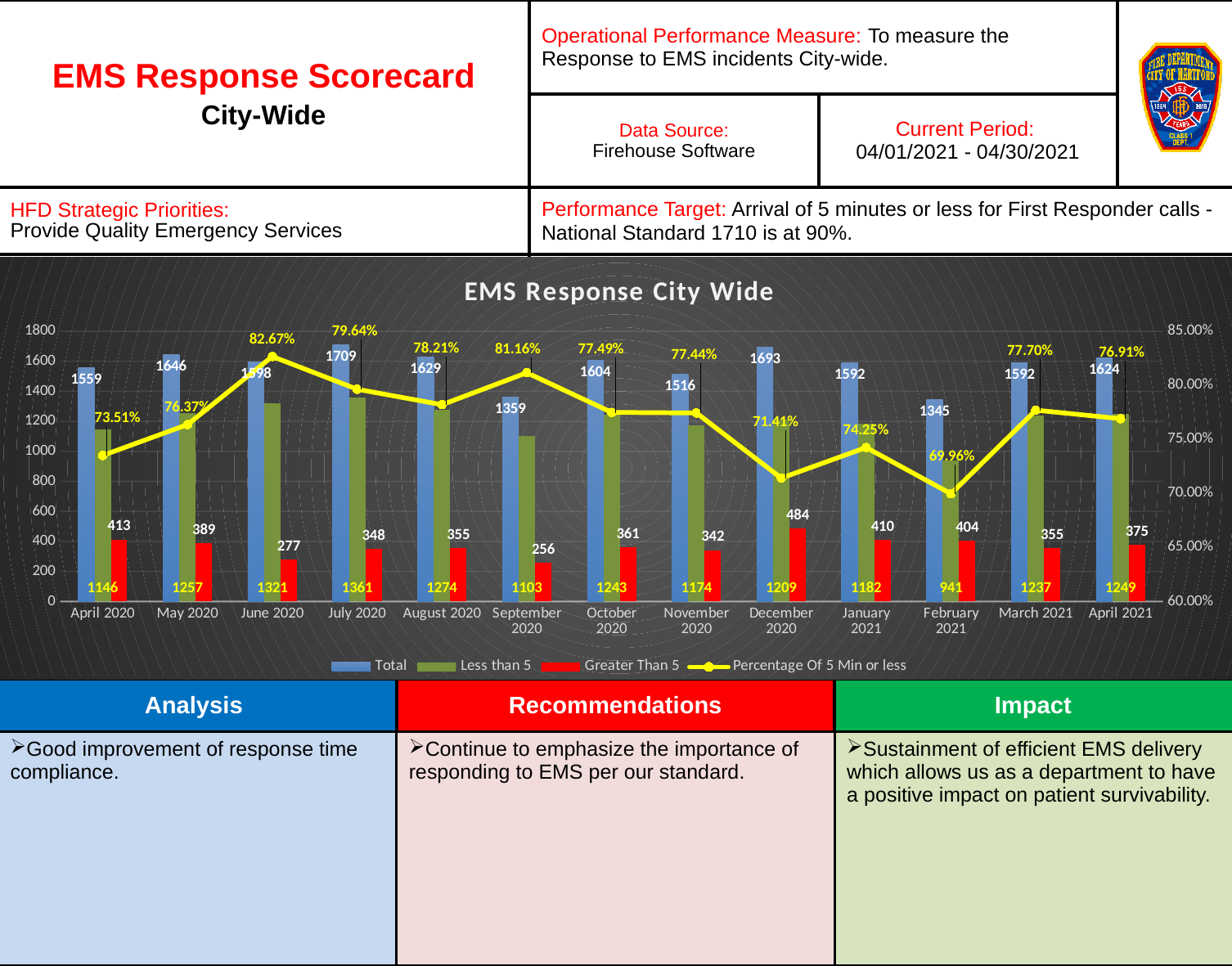
Which month has the lowest Percentage Of 5 Min or less? February 2021 Which month has the lowest Greater Than 5 value? September 2020 What is the difference between the Total for July 2020 and the Total for February 2021? 364 What is the Percentage Of 5 Min or less for June 2020? 82.67% What is the title of the chart? EMS Response City Wide Which is larger, the Greater Than 5 value for April 2020 or for May 2020? April 2020 How many months are shown on the x axis? 13 Which month has the highest Total? July 2020 What is the Less than 5 value for February 2021? 941 How many series does the legend list? 4 What is the Total value for July 2020? 1709 What is the Greater Than 5 value for December 2020? 484